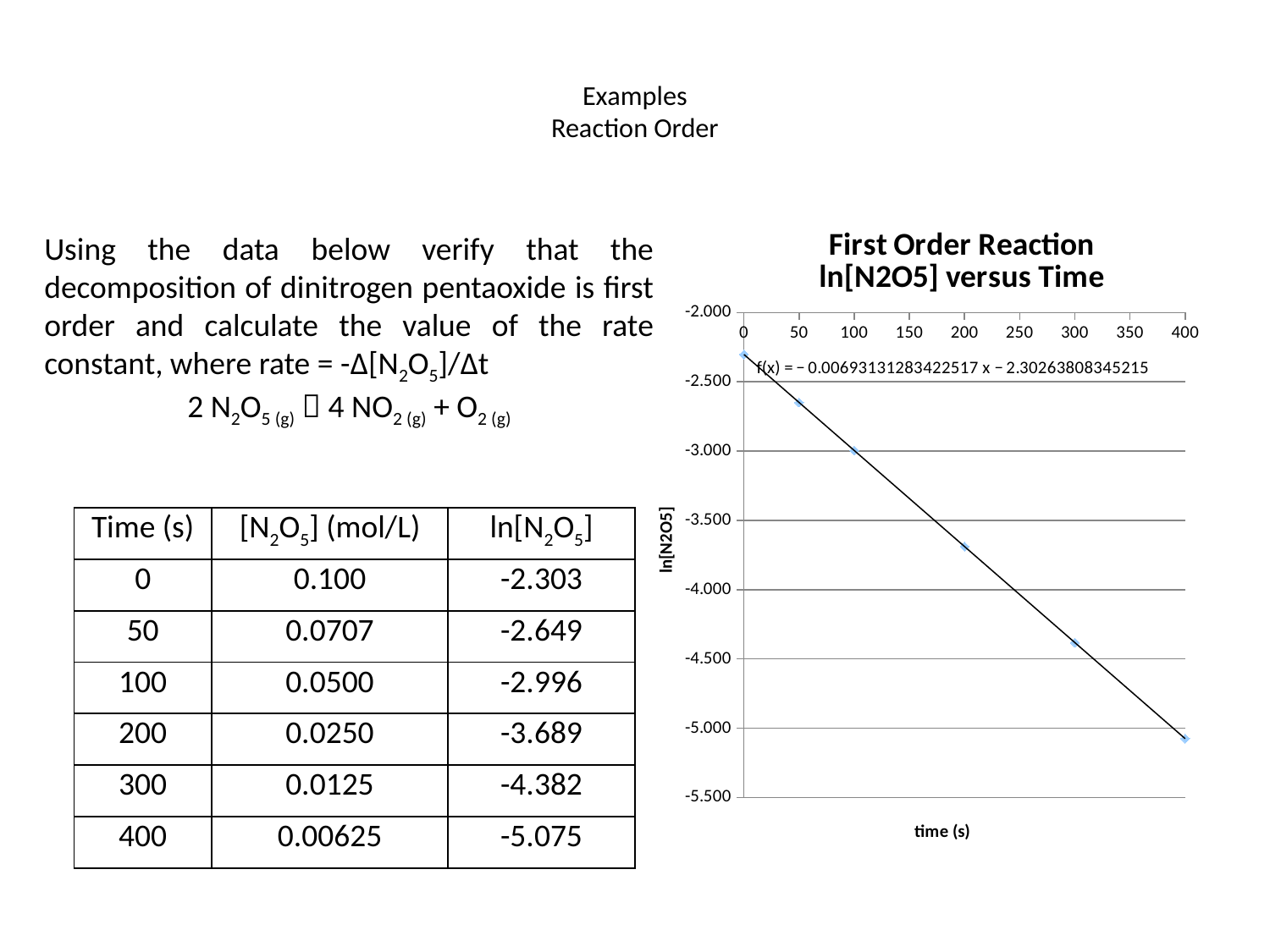
How many data points are plotted on the chart? 6 What is the value of ln[N2O5] at time 400 s? -5.075 What is the value of ln[N2O5] at time 0 s? -2.303 What is the title of the chart? First Order Reaction ln[N2O5] versus Time Do the plotted ln[N2O5] values rise or fall as time increases? fall Is the plotted value at time 50 s greater or less than -2.500? less At which time is the plotted ln[N2O5] value lowest? 400 Is the plotted value at time 300 s greater or less than -4.500? greater What is the slope of the fitted line equation f(x) shown on the chart? -0.00693131283422517 At which time is the plotted ln[N2O5] value highest? 0 What kind of chart is shown on the slide? scatter chart Is the plotted value at time 200 s greater or less than -3.500? less